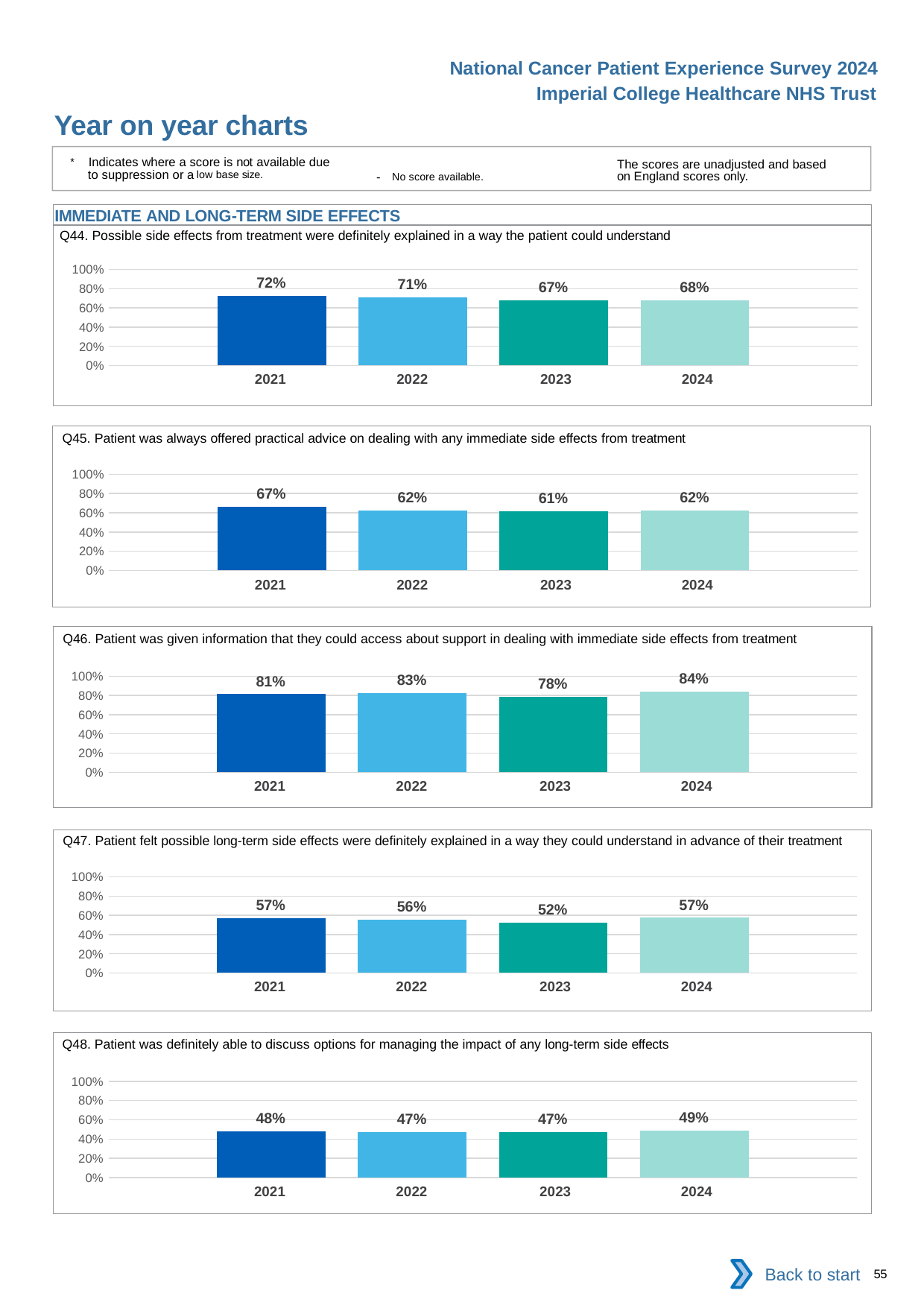
How many bars are plotted in the Q44 chart? 4 In the Q46 chart, which is larger, the value for 2022 or the value for 2023? 2022 In the Q46 chart, what is the value for 2024? 84% In the Q44 chart, what is the value for 2021? 72% What type of chart is used for Q46? Bar chart In the Q44 chart, which year has the lowest value? 2023 In the Q48 chart, what is the difference between the 2024 and 2022 values? 2 percentage points In the Q45 chart, which year has the highest value? 2021 In the Q45 chart, what is the difference between the 2021 and 2023 values? 6 percentage points In the Q47 chart, is the value for 2021 greater or less than 60%? less In the Q48 chart, which year has the highest value? 2024 In the Q47 chart, what is the value for 2023? 52%